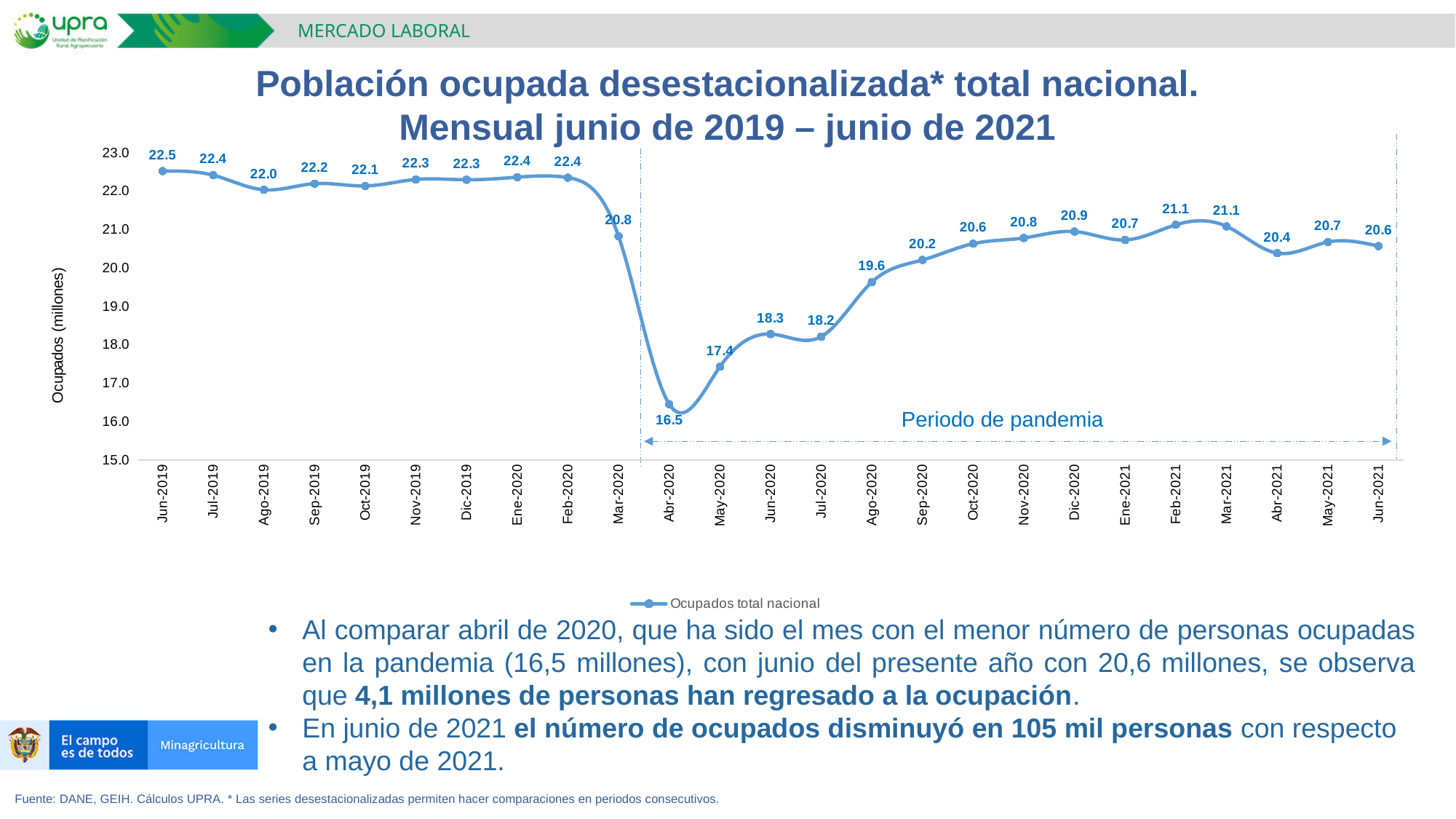
What is the difference between the values for Jun-2021 and Abr-2020? 4.1 Which is larger, the value for Dic-2020 or the value for Abr-2021? Dic-2020 What is the difference between the values for Feb-2020 and Mar-2020? 1.6 What type of chart is shown on the slide? line chart Which month has the lowest value? Abr-2020 What is the label on the vertical axis? Ocupados (millones) What is the value for Jun-2021? 20.6 How many series does the legend list? 1 What is the value for Abr-2020? 16.5 Which month has the highest value? Jun-2019 How many data points are plotted on the line? 25 What is the value for Feb-2020? 22.4